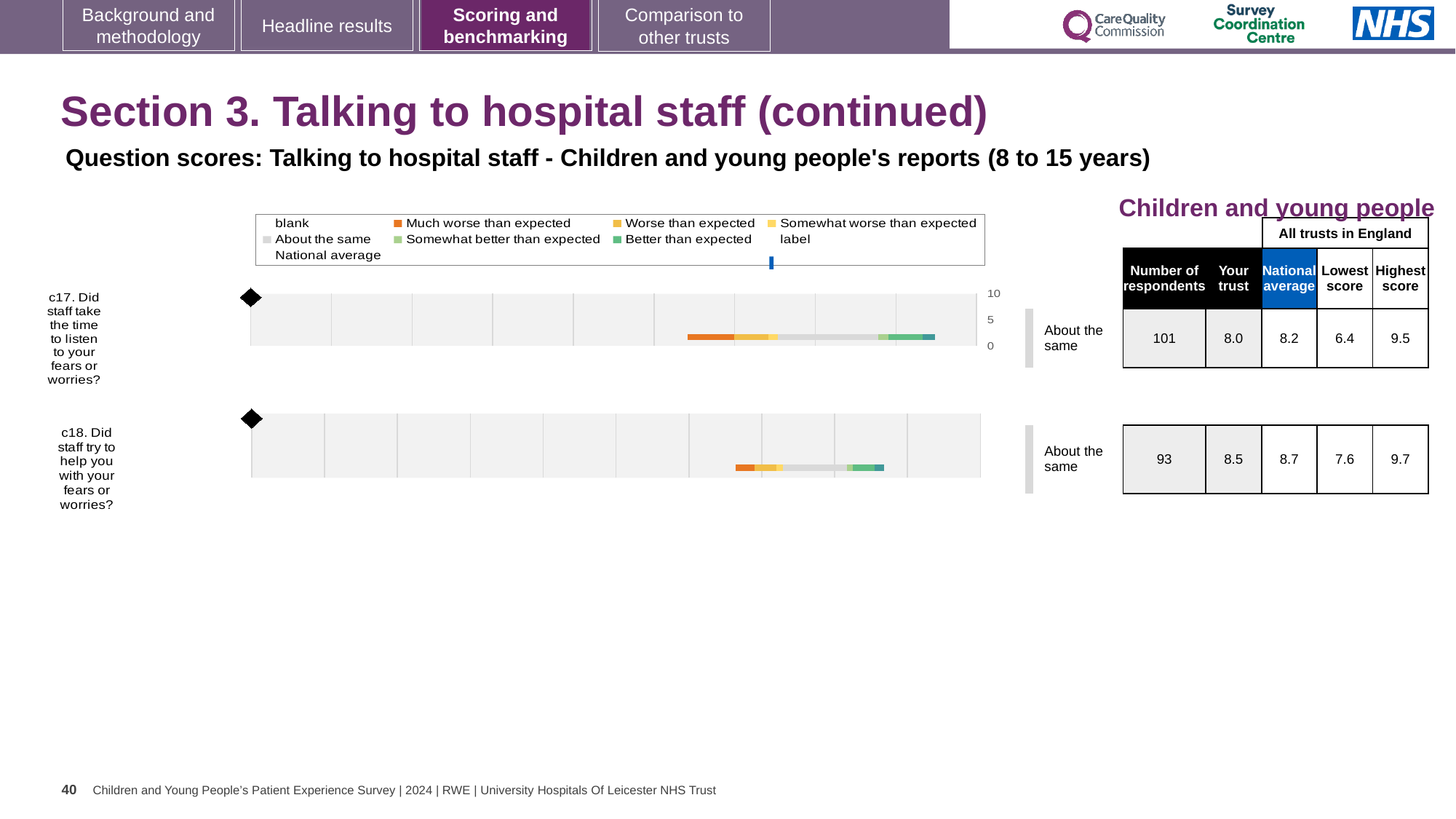
For question c17, what is the highest score among all trusts in England? 9.5 What benchmark category is shown next to the bar for question c17? About the same For question c18, what is the difference between the highest and lowest scores among all trusts in England? 2.1 For question c17 (Did staff take the time to listen to your fears or worries?), what is the 'Your trust' score? 8.0 For question c18, what is the lowest score among all trusts in England? 7.6 How many survey questions are plotted on the slide? 2 For question c18, what is the number of respondents? 93 For question c17, what is the national average score? 8.2 What kind of chart is used to show the expected-range bands for questions c17 and c18? bar chart Which question has the higher 'Your trust' score, c17 or c18? c18 For question c17, what is the difference between the national average and the 'Your trust' score? 0.2 For question c18 (Did staff try to help you with your fears or worries?), what is the 'Your trust' score? 8.5